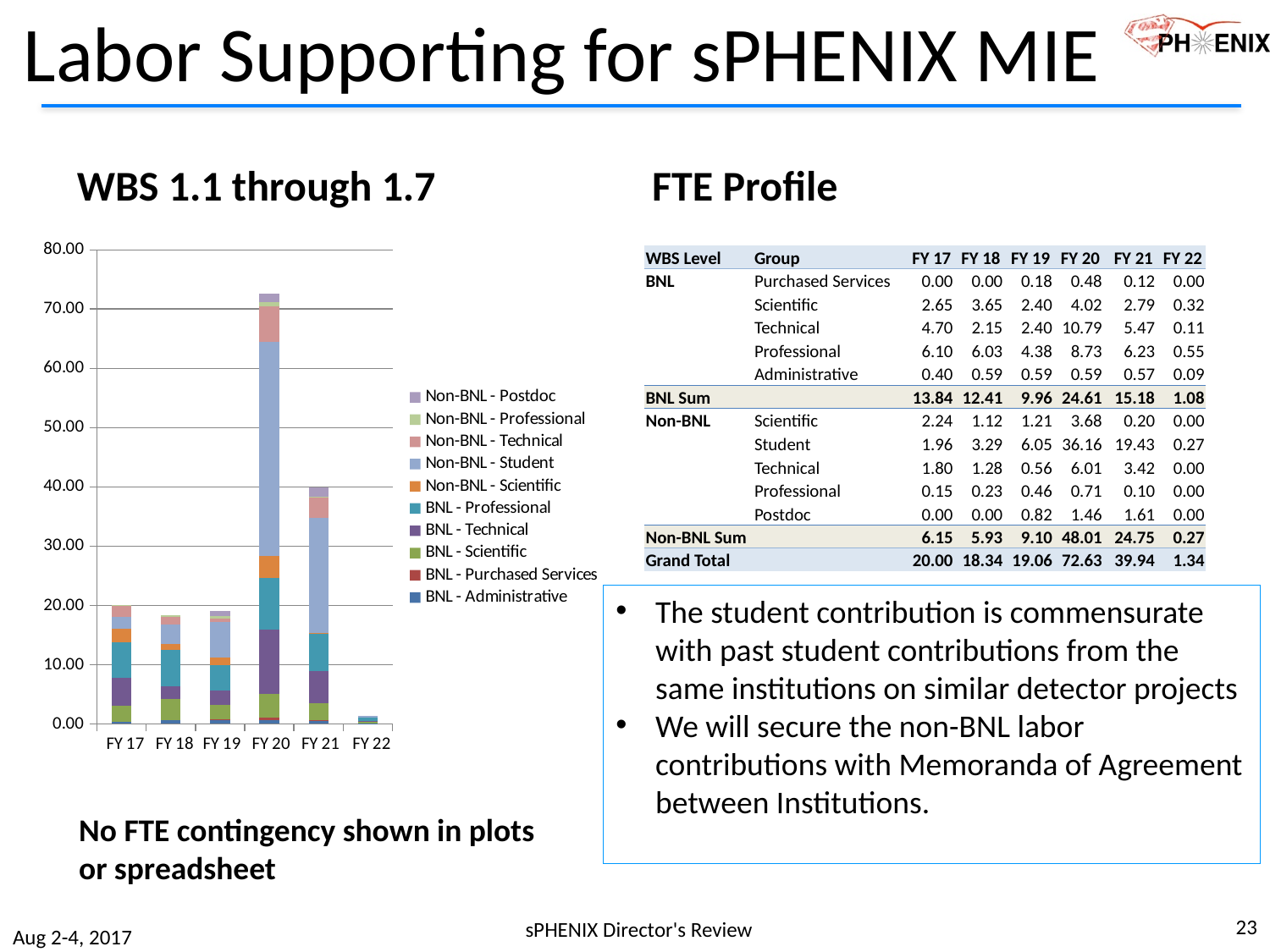
How many fiscal-year categories are shown on the x axis of the bar chart? 6 Which fiscal year has the tallest stacked bar in the chart? FY 20 Which bar is taller in the chart, FY 20 or FY 21? FY 20 What is the maximum value shown on the y axis of the bar chart? 80.00 Is the total height of the FY 20 bar greater or less than 70.00? greater How many series does the legend of the bar chart list? 10 Which series forms the largest segment of the FY 20 bar? Non-BNL - Student Is the total height of the FY 21 bar greater or less than 30.00? greater What type of chart is shown under the heading 'WBS 1.1 through 1.7'? Stacked bar chart Is the total height of the FY 22 bar greater or less than 10.00? less Which fiscal year has the shortest stacked bar in the chart? FY 22 Do the bar totals rise steadily from FY 17 to FY 22? No